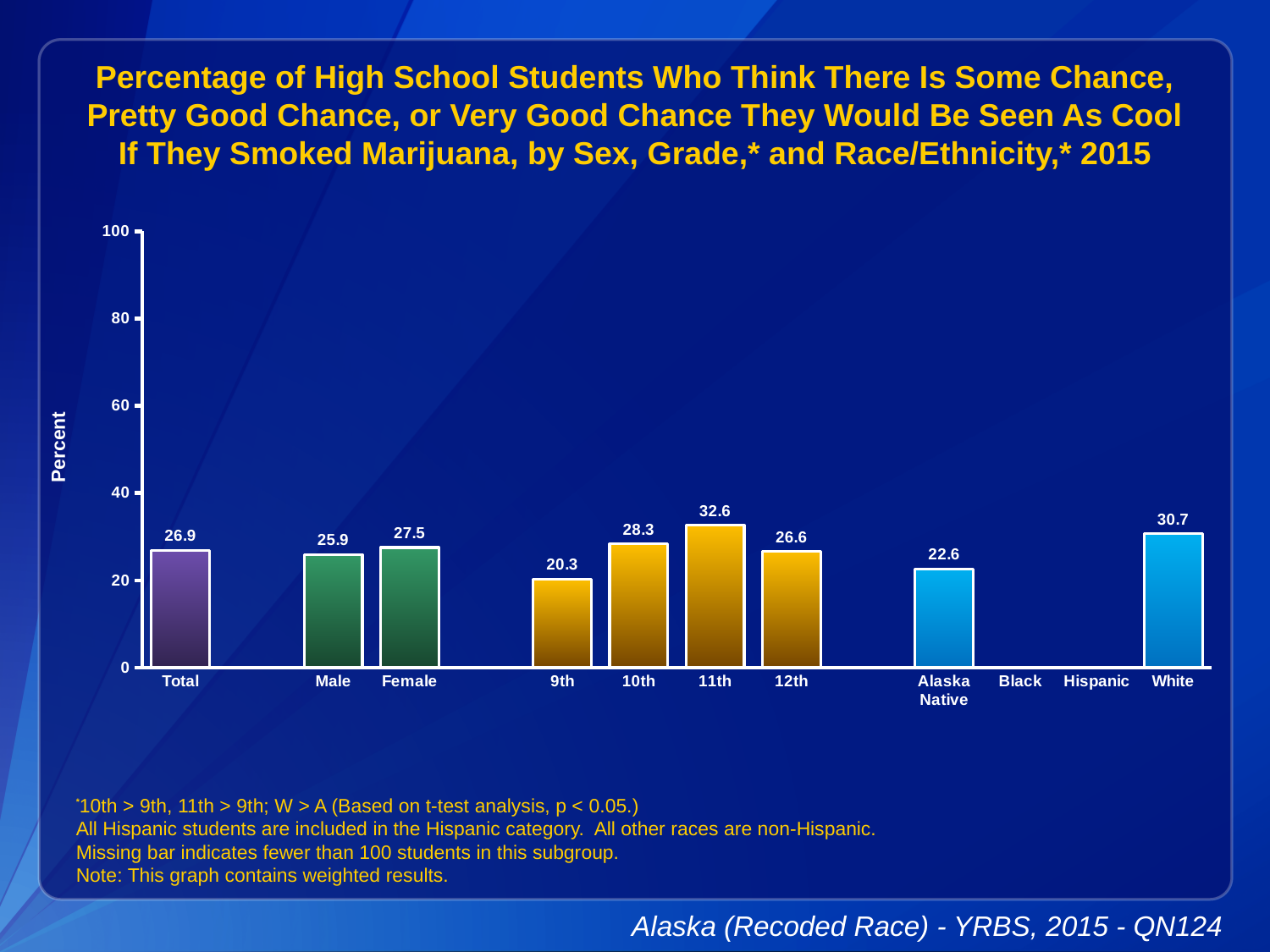
What is the difference between the Female and Male values? 1.6 What is the label on the y axis? Percent What is the value for Total? 26.9 Is the value for 9th grade greater or less than 40? less Which grade has the lowest value? 9th What is the difference between the 11th and 9th grade values? 12.3 What is the value for Alaska Native? 22.6 What is the value for 11th grade? 32.6 Which grade has the highest value? 11th How many bars are plotted on the chart? 9 What kind of chart is shown? bar chart Which is larger, the value for White or the value for Alaska Native? White